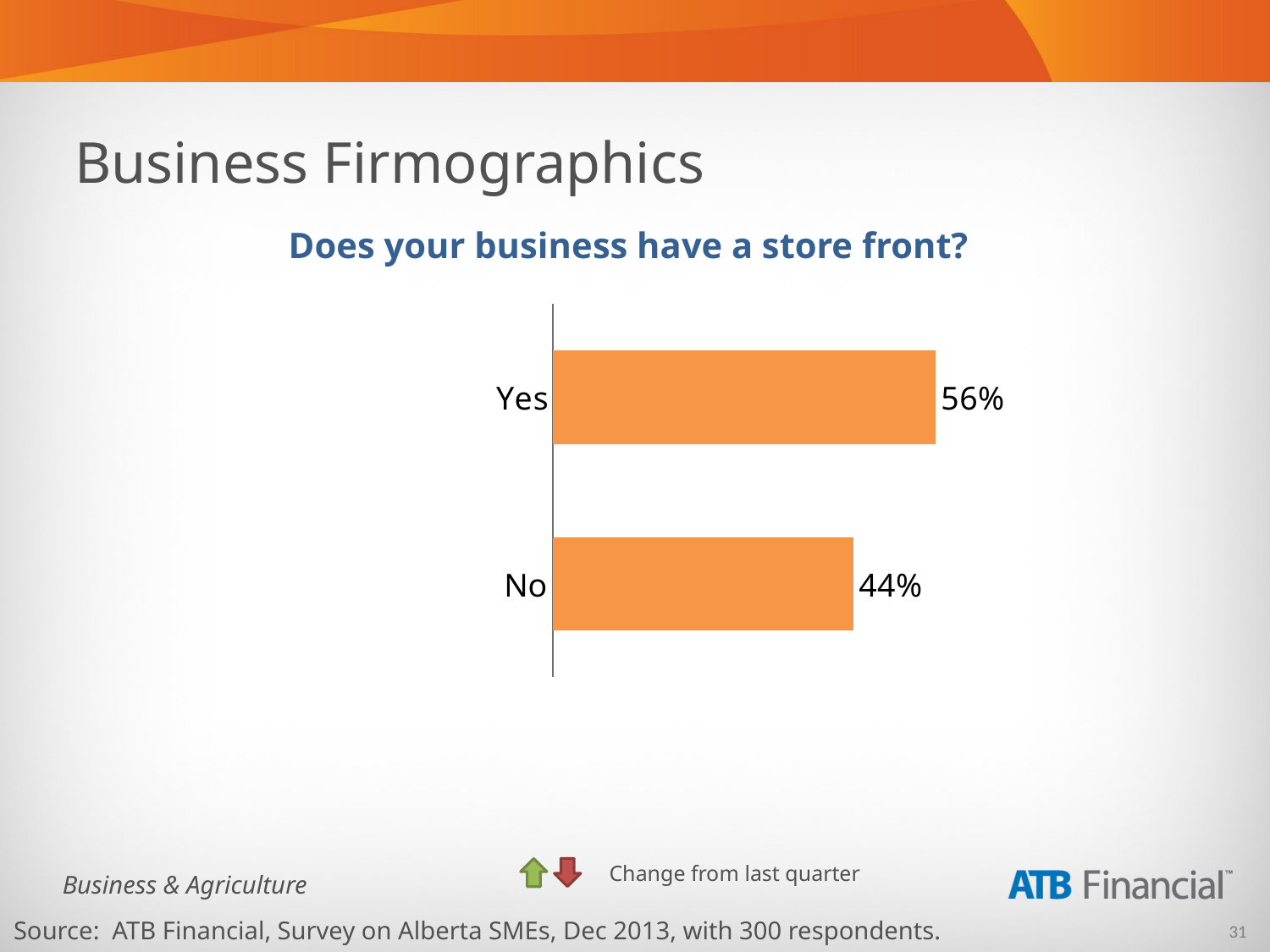
Is the value for Yes larger or smaller than the value for No? larger Which response has the lower percentage? No What is the difference in percentage points between the Yes and No responses? 12 percentage points What percentage of respondents answered "No" to having a store front? 44% How many response categories are shown in the chart? 2 What colour are the bars in the chart? Orange What percentage of respondents answered "Yes" to having a store front? 56% What question does the chart title ask? Does your business have a store front? Which response has the higher percentage, Yes or No? Yes What is the total of the Yes and No percentages? 100% What type of chart is used on this slide? Bar chart